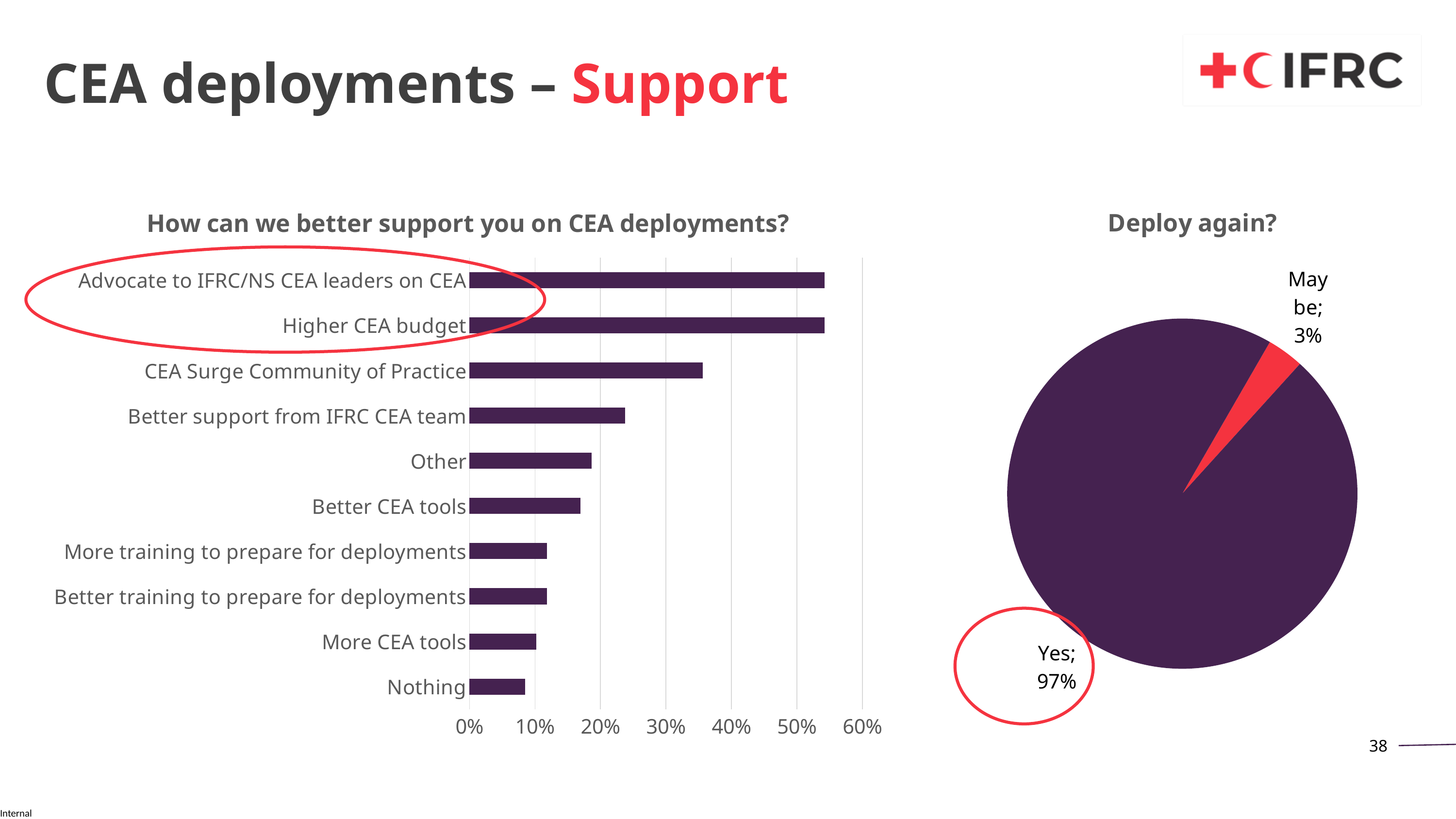
In the "How can we better support you on CEA deployments?" chart, is the value for "Nothing" greater or less than 10%? less In the "How can we better support you on CEA deployments?" chart, which is larger: "CEA Surge Community of Practice" or "Other"? CEA Surge Community of Practice In the "How can we better support you on CEA deployments?" chart, how many categories are shown? 10 In the "How can we better support you on CEA deployments?" chart, is the value for "CEA Surge Community of Practice" greater or less than 30%? greater In the "How can we better support you on CEA deployments?" chart, is the value for "Better support from IFRC CEA team" greater or less than 30%? less In the "Deploy again?" chart, what is the value for "May be"? 3% In the "How can we better support you on CEA deployments?" chart, which category has the lowest value? Nothing What kind of chart is "How can we better support you on CEA deployments?"? bar chart In the "Deploy again?" chart, what share of the pie is "Yes"? 97% In the "Deploy again?" chart, how many slices does the pie have? 2 What kind of chart is "Deploy again?"? pie chart